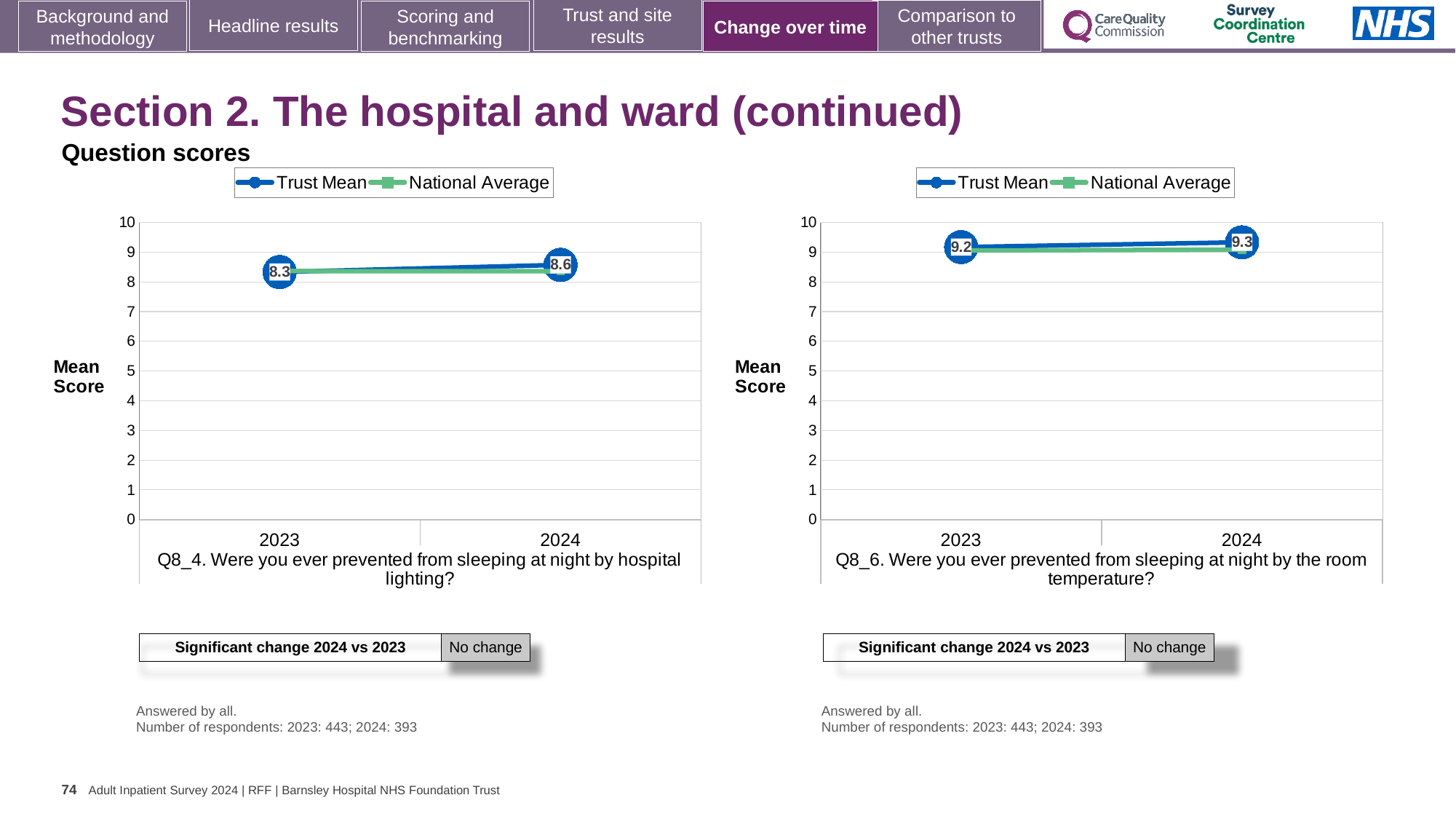
How many years are plotted on the x axis of the left chart (Q8_4)? 2 How many series does the legend of the right chart (Q8_6) list? 2 In the right chart (Q8_6), what is the Trust Mean score for 2024? 9.3 In the left chart (Q8_4), what is the Trust Mean score for 2023? 8.3 In the left chart (Q8_4), is the National Average value for 2023 greater or less than 9? less In the left chart (Q8_4), does the Trust Mean rise or fall from 2023 to 2024? rise In the left chart (Q8_4), by how much did the Trust Mean change from 2023 to 2024? 0.3 In the right chart (Q8_6), what is the Trust Mean score for 2023? 9.2 What kind of chart is the right chart (Q8_6)? line chart In the right chart (Q8_6), by how much did the Trust Mean change from 2023 to 2024? 0.1 In the left chart (Q8_4), what is the Trust Mean score for 2024? 8.6 In the left chart (Q8_4), which year has the higher Trust Mean score? 2024